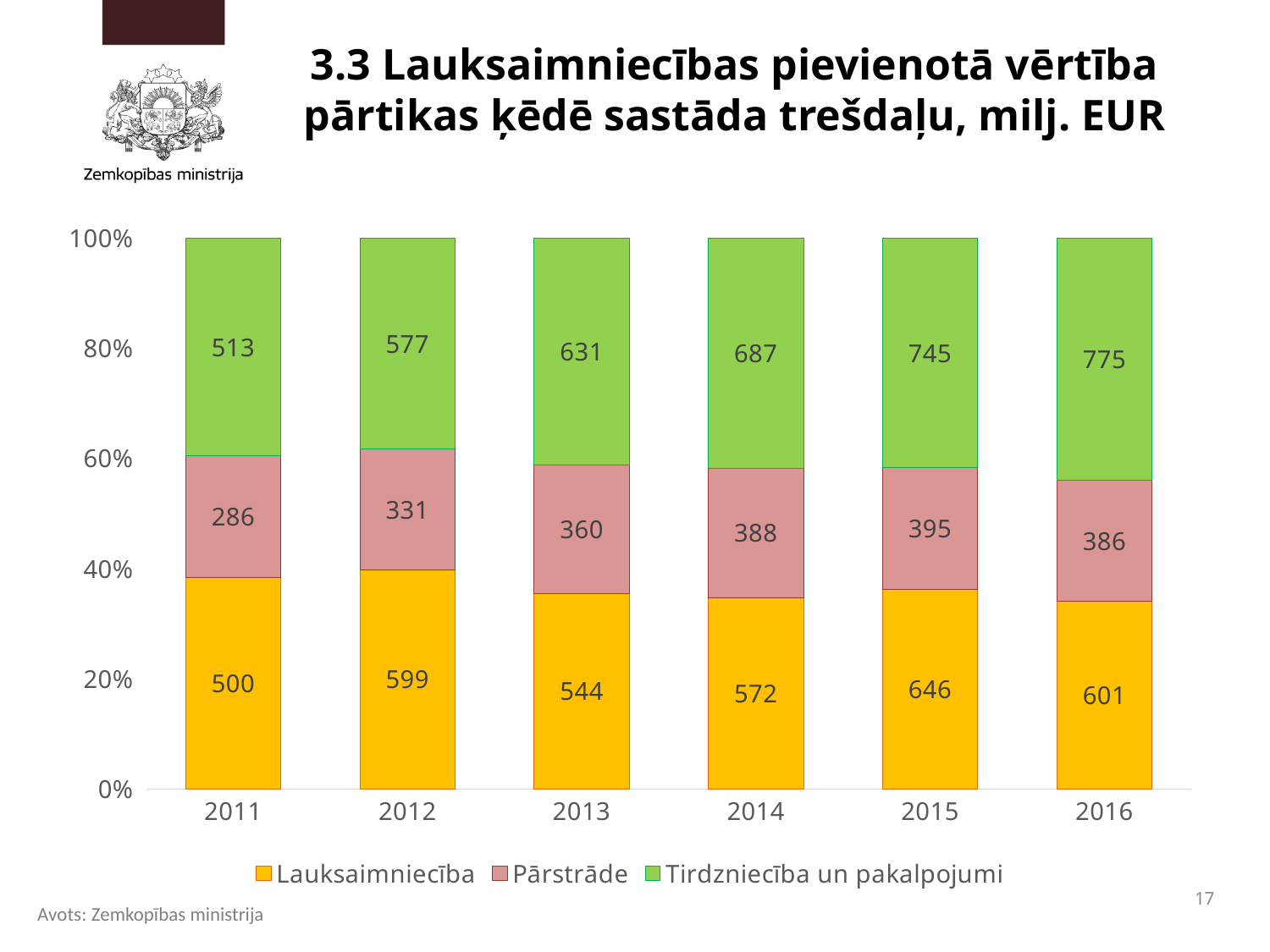
How many years are shown on the x axis? 6 Which is larger, the Pārstrāde value for 2014 or for 2016? 2014 What is the value for Pārstrāde in 2013? 360 What is the value for Tirdzniecība un pakalpojumi in 2016? 775 What is the difference between the Lauksaimniecība values for 2015 and 2016? 45 In which year is the value for Tirdzniecība un pakalpojumi highest? 2016 How many series does the legend list? 3 In which year is the value for Lauksaimniecība lowest? 2011 What is the value for Lauksaimniecība in 2015? 646 What kind of chart is shown on the slide? Stacked bar chart What is the total of the three values in the 2011 bar? 1299 Does the value for Tirdzniecība un pakalpojumi rise or fall from 2011 to 2016? Rise